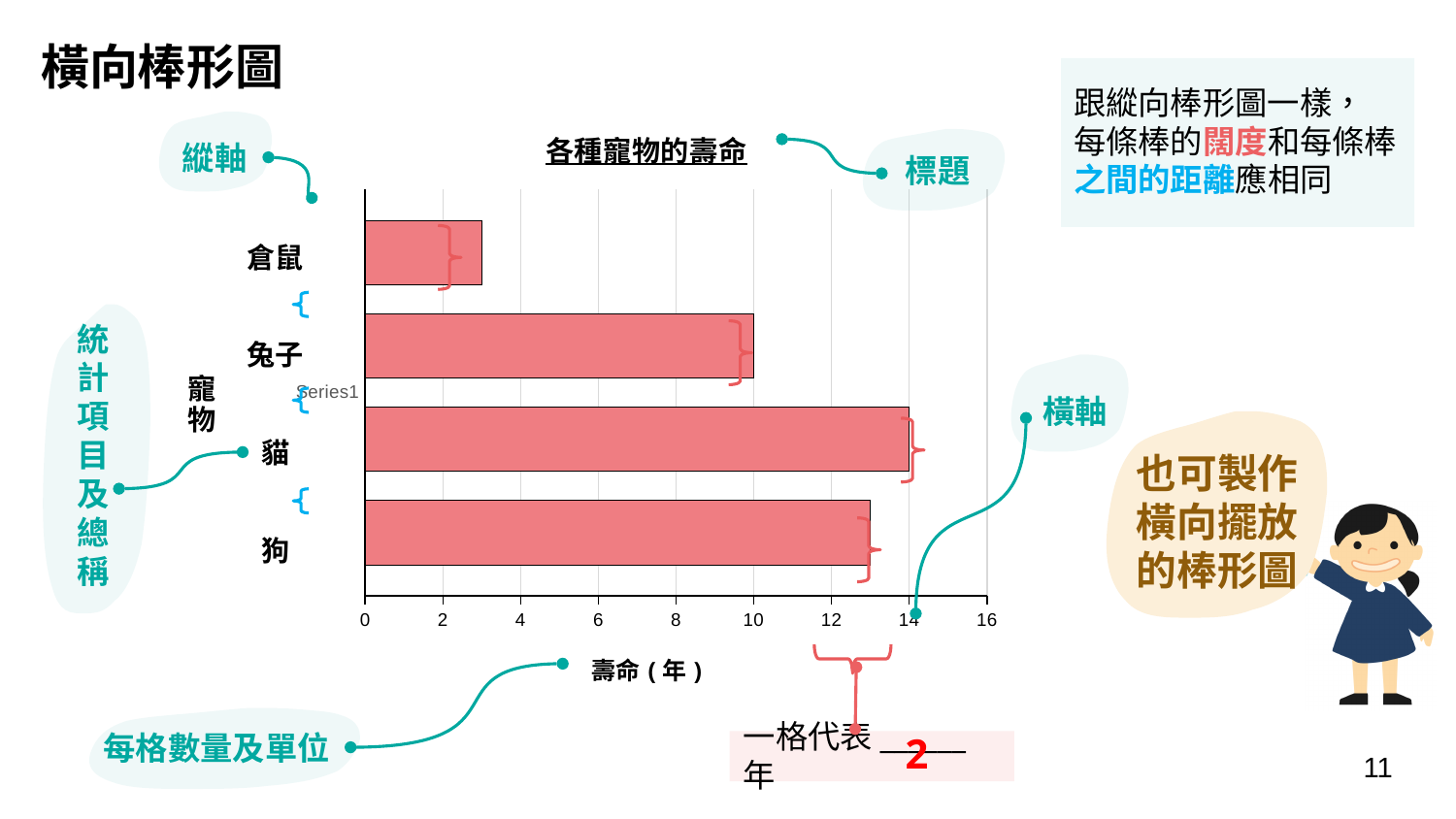
What is the label of the horizontal axis of the chart? 壽命 ( 年 ) Is the value for 狗 greater or less than 12? greater How many pet categories are shown in the chart? 4 Which has a larger value, 狗 or 兔子? 狗 Which pet has the highest value in the chart? 貓 What is the difference between the values for 貓 and 兔子? 4 What is the value for 兔子 in the chart? 10 What is the value for 貓 in the chart? 14 What kind of chart is shown on the slide? bar chart Is the value for 倉鼠 greater or less than 4? less What is the title of the chart? 各種寵物的壽命 Which pet has the lowest value in the chart? 倉鼠